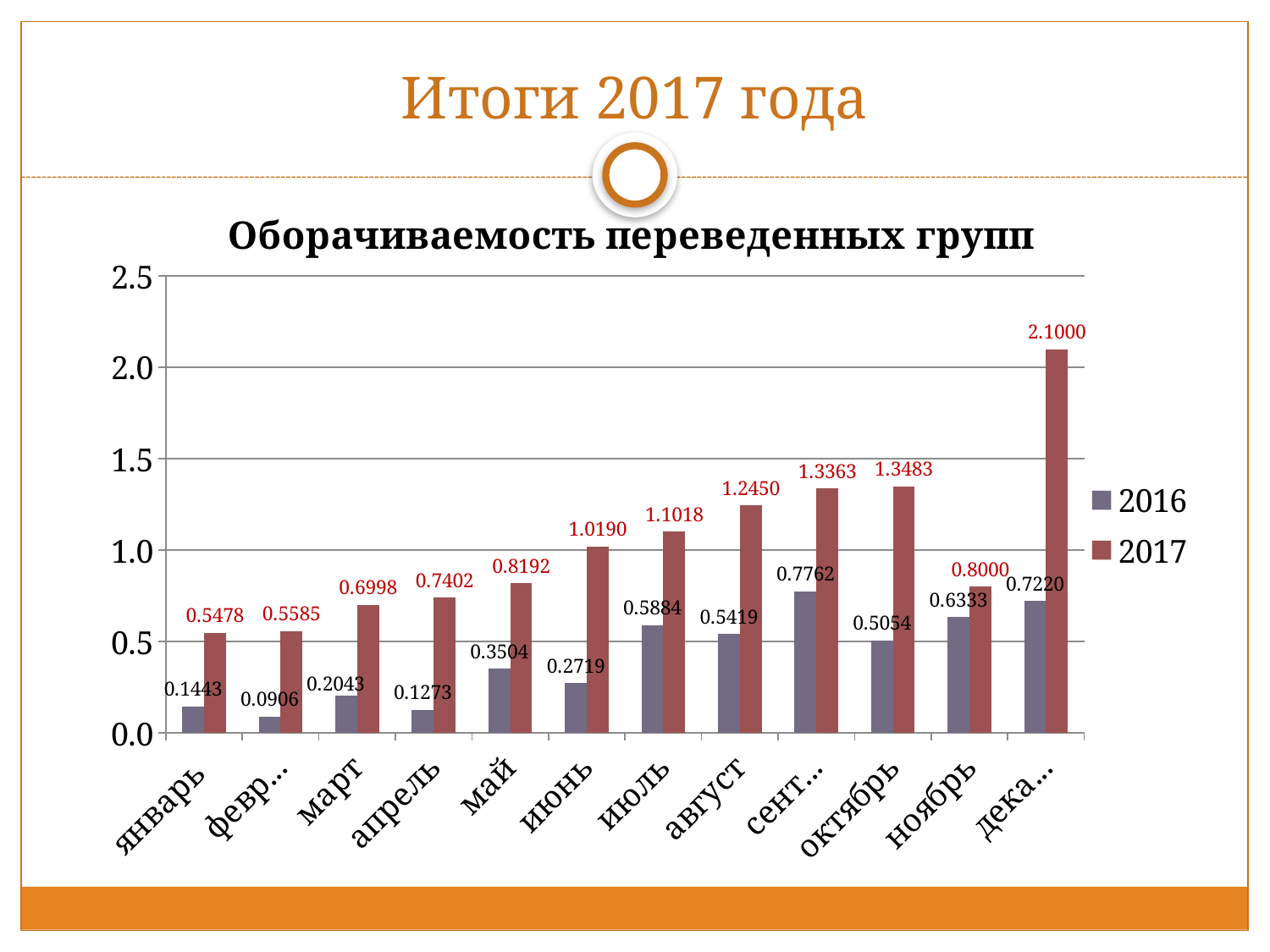
What is the 2016 value for май? 0.3504 What is the 2017 value for июль? 1.1018 Which is larger: the 2017 value for октябрь or the 2017 value for ноябрь? октябрь How many series does the legend list? 2 What is the lowest value shown in the 2016 series? 0.0906 What kind of chart is shown on the slide? bar chart What is the title of the chart? Оборачиваемость переведенных групп How many months are shown on the x axis? 12 What is the 2016 value for октябрь? 0.5054 Is the 2017 value for август greater or less than 1.0? greater What is the highest value shown in the 2017 series? 2.1000 What is the difference between the 2017 and 2016 values for июль? 0.5134